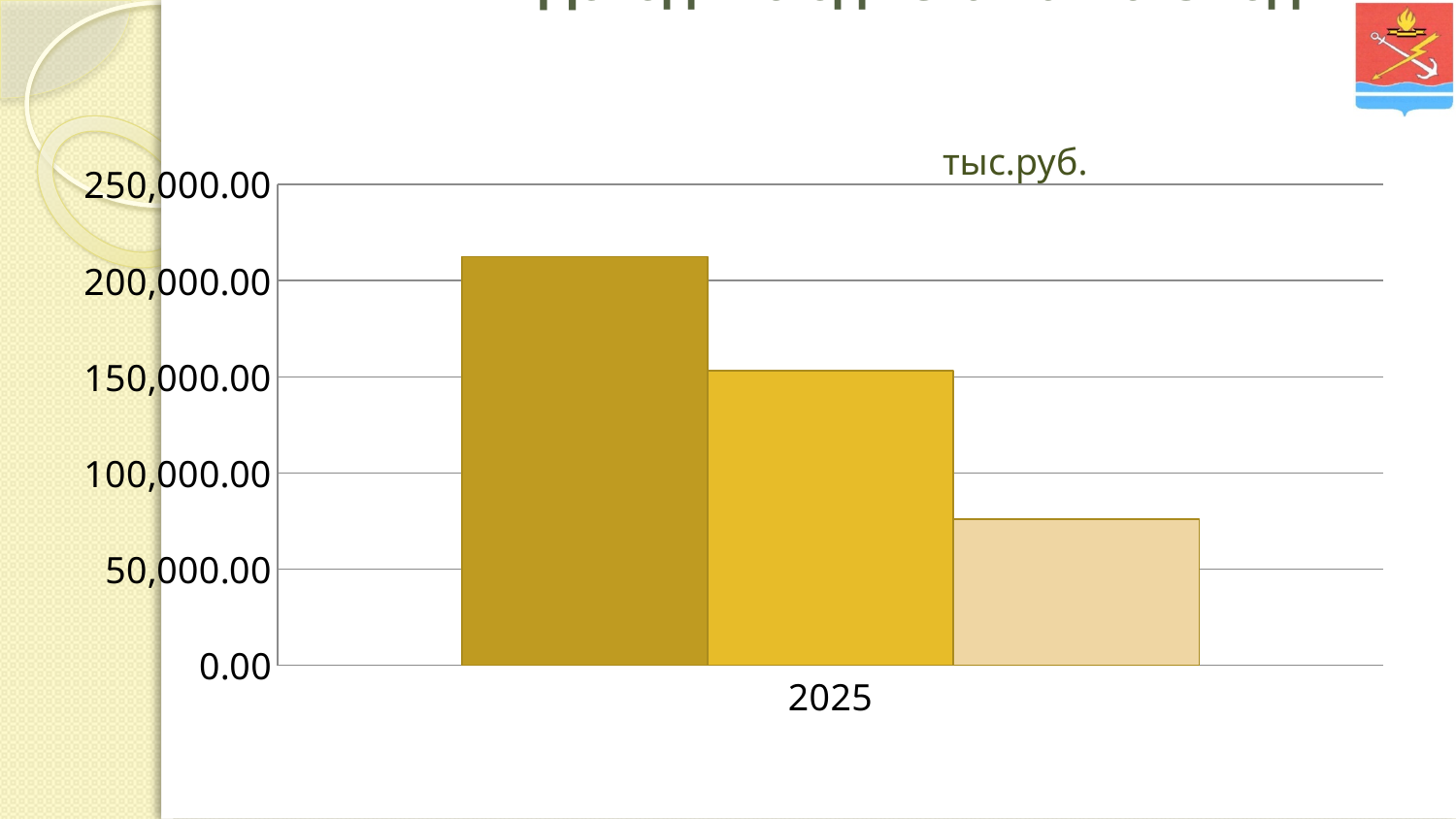
Which of the three bars is the shortest? the rightmost (lightest) bar Is the value of the middle bar greater or less than 100,000.00? greater Do the bar values rise or fall from left to right across the chart? fall What kind of chart is shown on the slide? bar chart What is the only category label on the x axis of the chart? 2025 Which of the three bars is the tallest? the leftmost (darkest) bar What unit label is printed above the chart's plot area? тыс.руб. Is the value of the middle bar greater or less than 200,000.00? less Is the value of the rightmost (lightest) bar greater or less than 100,000.00? less How many categories are shown on the x axis of the chart? 1